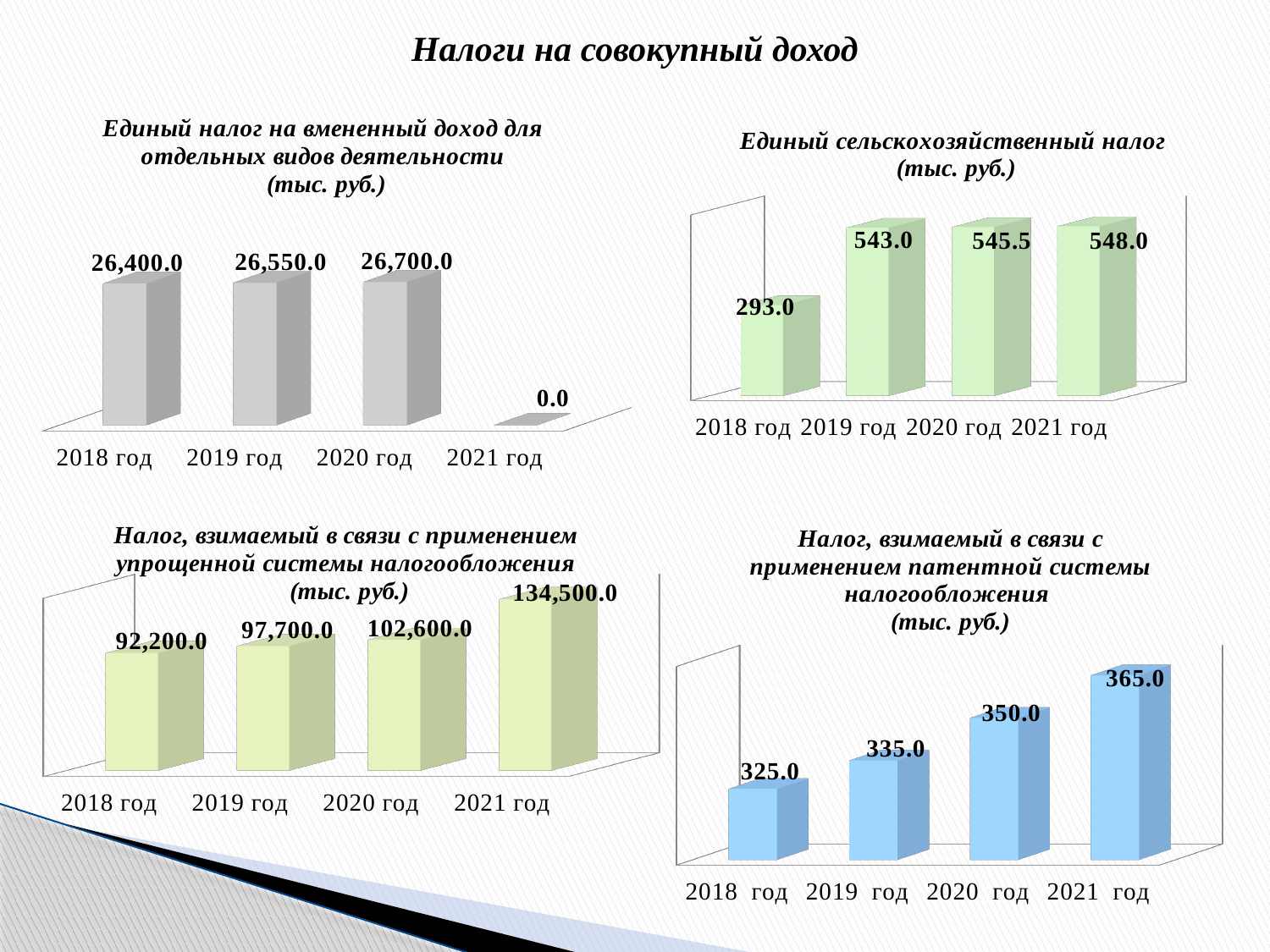
In the top-right chart (Единый сельскохозяйственный налог), what is the difference between the 2021 год and 2018 год values? 255.0 In the bottom-right chart (патентной системы налогообложения), which is larger, the value for 2019 год or 2021 год? 2021 год In the bottom-left chart (упрощенной системы налогообложения), what is the value for 2021 год? 134,500.0 In the top-right chart (Единый сельскохозяйственный налог), which year has the lowest value? 2018 год In the top-left chart (Единый налог на вмененный доход), what is the value for 2019 год? 26,550.0 In the bottom-left chart (упрощенной системы налогообложения), what is the difference between the 2020 год and 2019 год values? 4,900.0 In the top-left chart (Единый налог на вмененный доход), what is the value for 2021 год? 0.0 In the bottom-left chart (упрощенной системы налогообложения), do the values rise or fall from 2018 год to 2021 год? rise In the top-right chart (Единый сельскохозяйственный налог), what is the value for 2018 год? 293.0 In the top-left chart (Единый налог на вмененный доход), which year has the highest value? 2020 год How many charts are shown on the slide? 4 In the bottom-right chart (патентной системы налогообложения), what is the value for 2020 год? 350.0